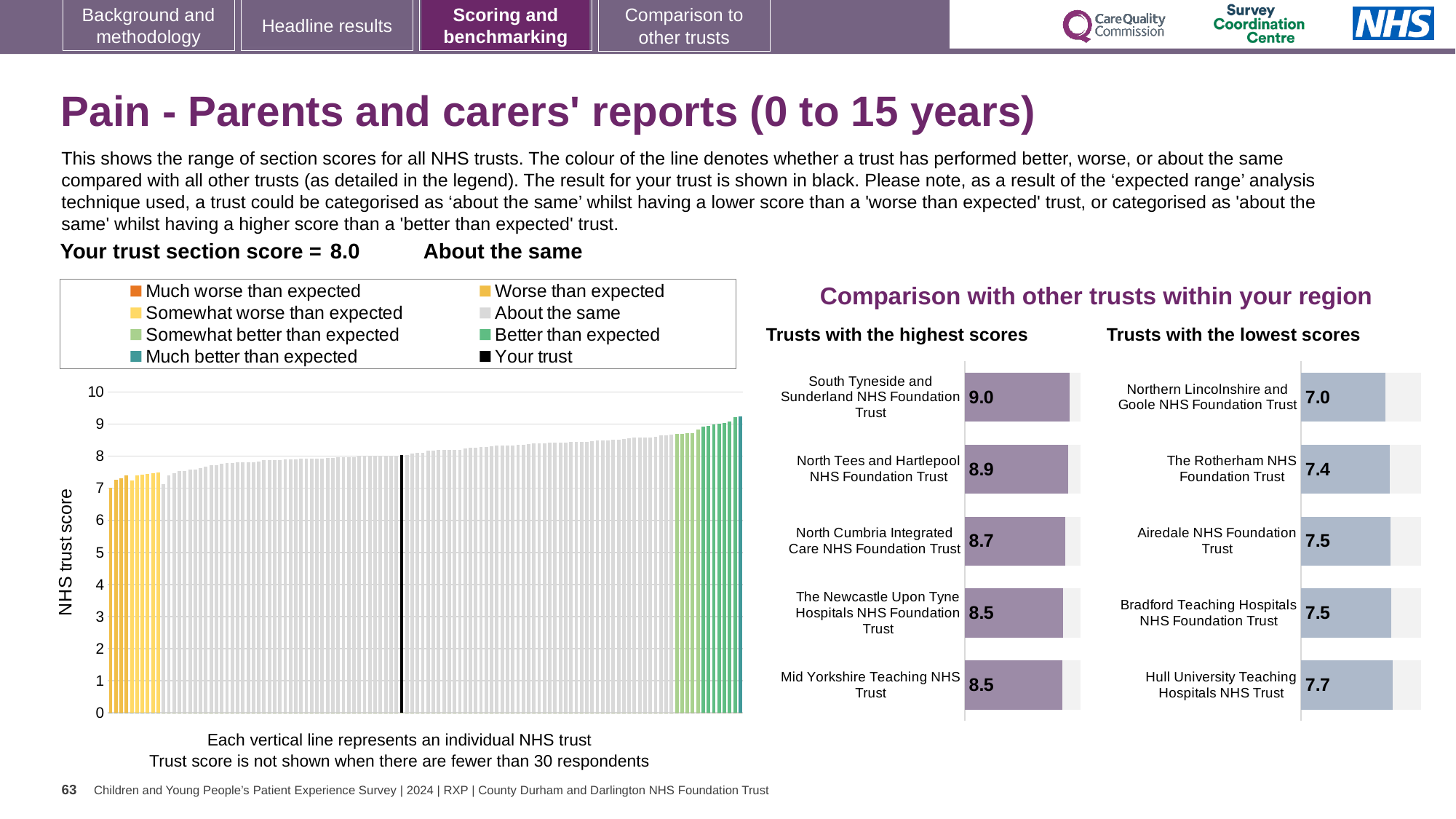
In the main chart on the left, do the trust scores rise or fall from left to right along the x axis? rise In the 'Trusts with the highest scores' chart, what is the score for South Tyneside and Sunderland NHS Foundation Trust? 9.0 In the 'Trusts with the highest scores' chart, which trust has the highest score? South Tyneside and Sunderland NHS Foundation Trust In the 'Trusts with the lowest scores' chart, which trust has the lowest score? Northern Lincolnshire and Goole NHS Foundation Trust In the 'Trusts with the highest scores' chart, what is the difference between the scores of South Tyneside and Sunderland NHS Foundation Trust and Mid Yorkshire Teaching NHS Trust? 0.5 In the 'Trusts with the lowest scores' chart, what is the difference between the scores of Hull University Teaching Hospitals NHS Trust and Northern Lincolnshire and Goole NHS Foundation Trust? 0.7 How many entries does the legend of the main chart on the left list? 8 How many trusts are shown in the 'Trusts with the highest scores' chart? 5 In the main chart on the left, what is the section score for your trust (the black bar)? 8.0 In the 'Trusts with the lowest scores' chart, what is the score for Hull University Teaching Hospitals NHS Trust? 7.7 In the 'Trusts with the lowest scores' chart, which has the higher score: The Rotherham NHS Foundation Trust or Airedale NHS Foundation Trust? Airedale NHS Foundation Trust In the 'Trusts with the highest scores' chart, what is the score for North Cumbria Integrated Care NHS Foundation Trust? 8.7